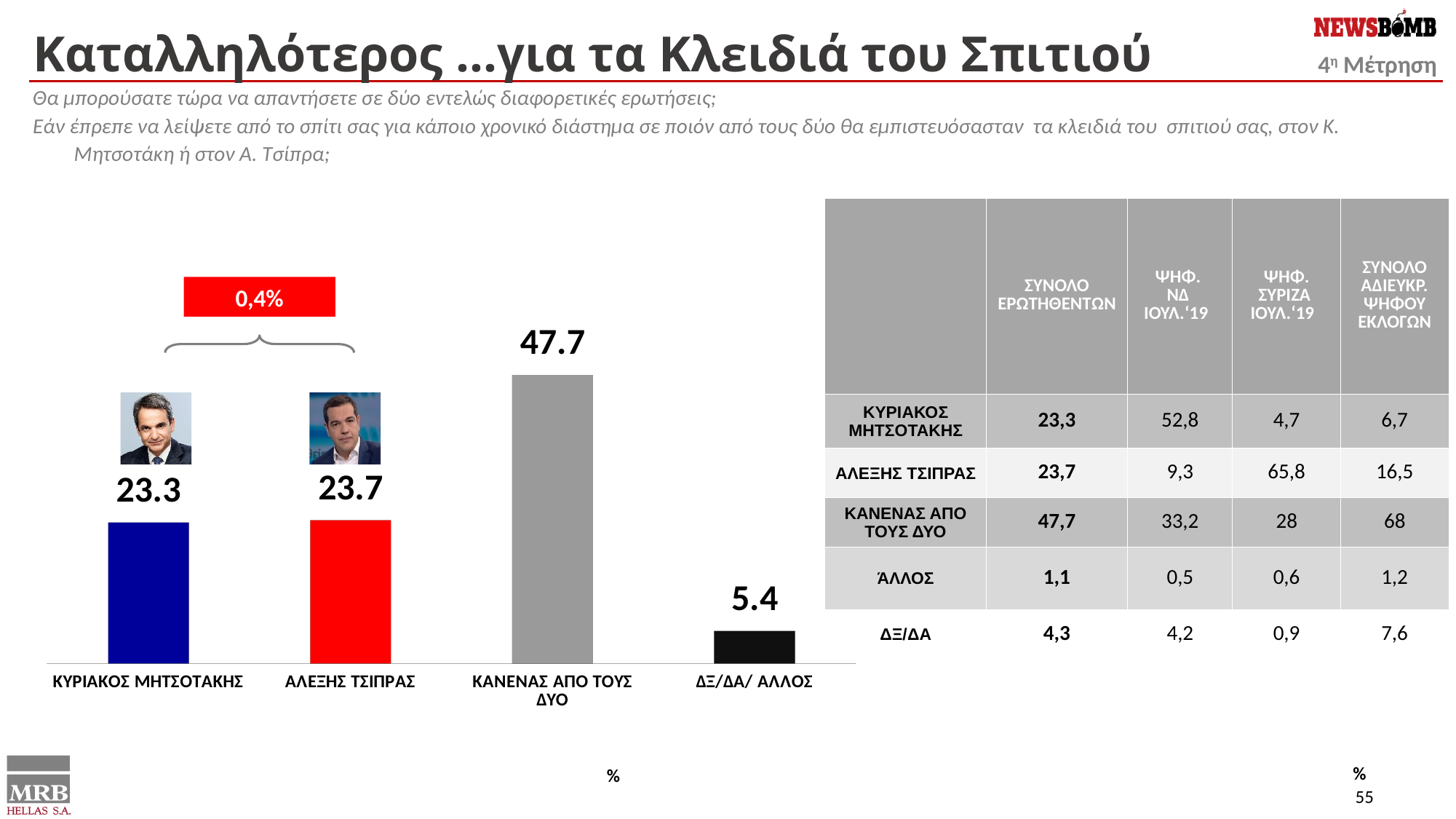
What is the difference between the values for ΚΑΝΕΝΑΣ ΑΠΟ ΤΟΥΣ ΔΥΟ and ΔΞ/ΔΑ/ ΑΛΛΟΣ in the bar chart? 42.3 Which category has the highest value in the bar chart? ΚΑΝΕΝΑΣ ΑΠΟ ΤΟΥΣ ΔΥΟ Which is larger in the bar chart: the value for ΚΑΝΕΝΑΣ ΑΠΟ ΤΟΥΣ ΔΥΟ or the value for ΑΛΕΞΗΣ ΤΣΙΠΡΑΣ? ΚΑΝΕΝΑΣ ΑΠΟ ΤΟΥΣ ΔΥΟ What is the value for ΑΛΕΞΗΣ ΤΣΙΠΡΑΣ in the bar chart? 23.7 What difference is shown in the red box above the bracket between the first two bars? 0,4% What is the value for ΔΞ/ΔΑ/ ΑΛΛΟΣ in the bar chart? 5.4 What is the value for ΚΑΝΕΝΑΣ ΑΠΟ ΤΟΥΣ ΔΥΟ in the bar chart? 47.7 Which category has the lowest value in the bar chart? ΔΞ/ΔΑ/ ΑΛΛΟΣ How many categories are shown in the bar chart? 4 What is the difference between the values for ΑΛΕΞΗΣ ΤΣΙΠΡΑΣ and ΚΥΡΙΑΚΟΣ ΜΗΤΣΟΤΑΚΗΣ in the bar chart? 0.4 What is the value for ΚΥΡΙΑΚΟΣ ΜΗΤΣΟΤΑΚΗΣ in the bar chart? 23.3 What kind of chart is shown on the slide? Bar chart